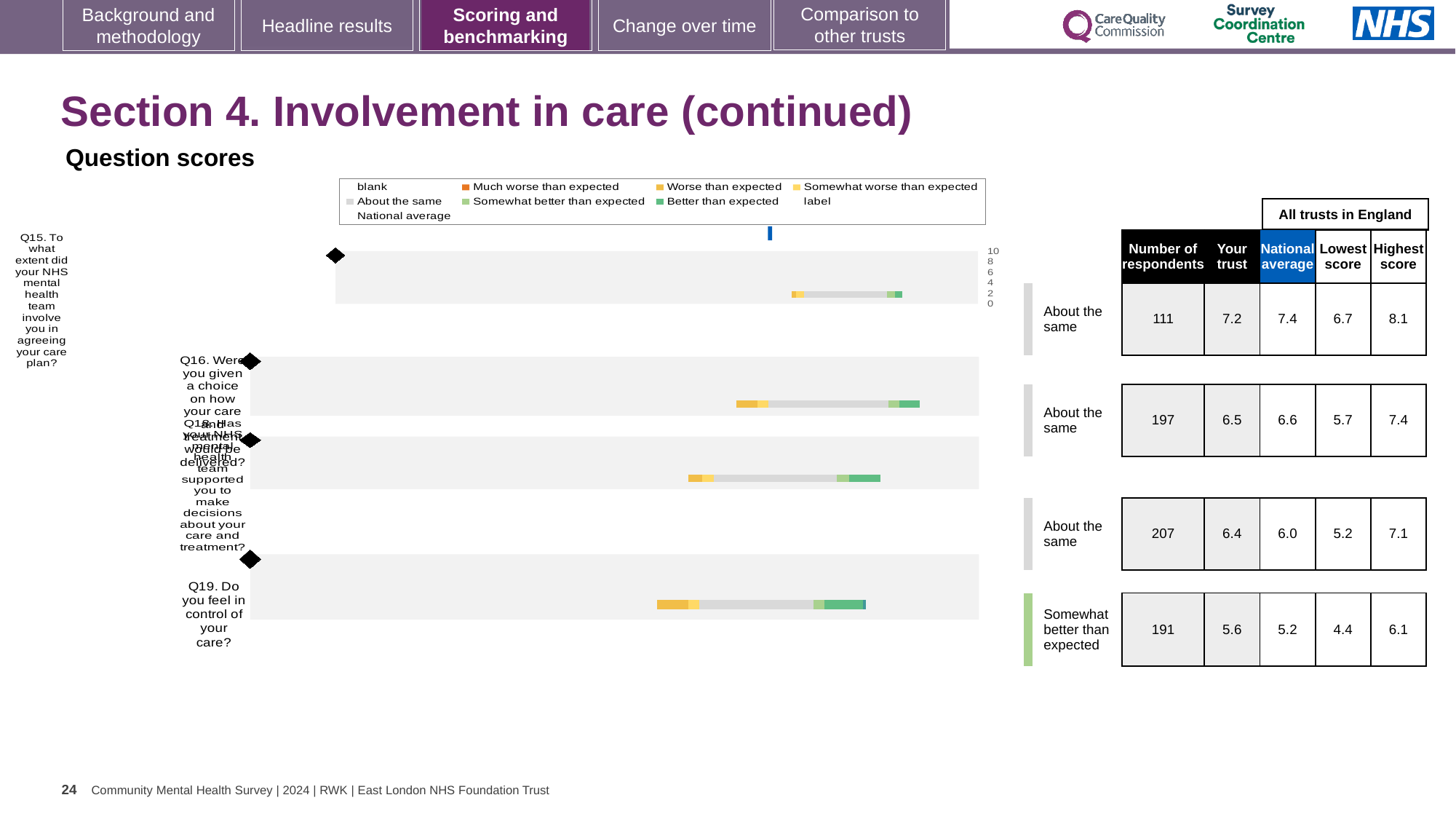
What benchmark category is shown for Q19 (feeling in control of your care)? Somewhat better than expected In the table next to the chart, what is the national average for Q16 (choice on how care and treatment would be delivered)? 6.6 For Q16, which is larger: the 'Your trust' score or the national average? National average Which question has the largest number of respondents? Q18 How many questions (categories) are plotted in the question scores chart? 4 Which question has the lowest 'Your trust' score? Q19 What is the highest score among all trusts in England for Q19 (feeling in control of your care)? 6.1 What is the lowest score among all trusts in England for Q15? 6.7 What kind of chart is used to show the question scores on this slide? bar chart How many respondents are listed for Q18 (support to make decisions about care and treatment)? 207 For Q18, how much higher is the 'Your trust' score than the national average? 0.4 In the table next to the chart, what is the 'Your trust' score for Q15 (involvement in agreeing your care plan)? 7.2